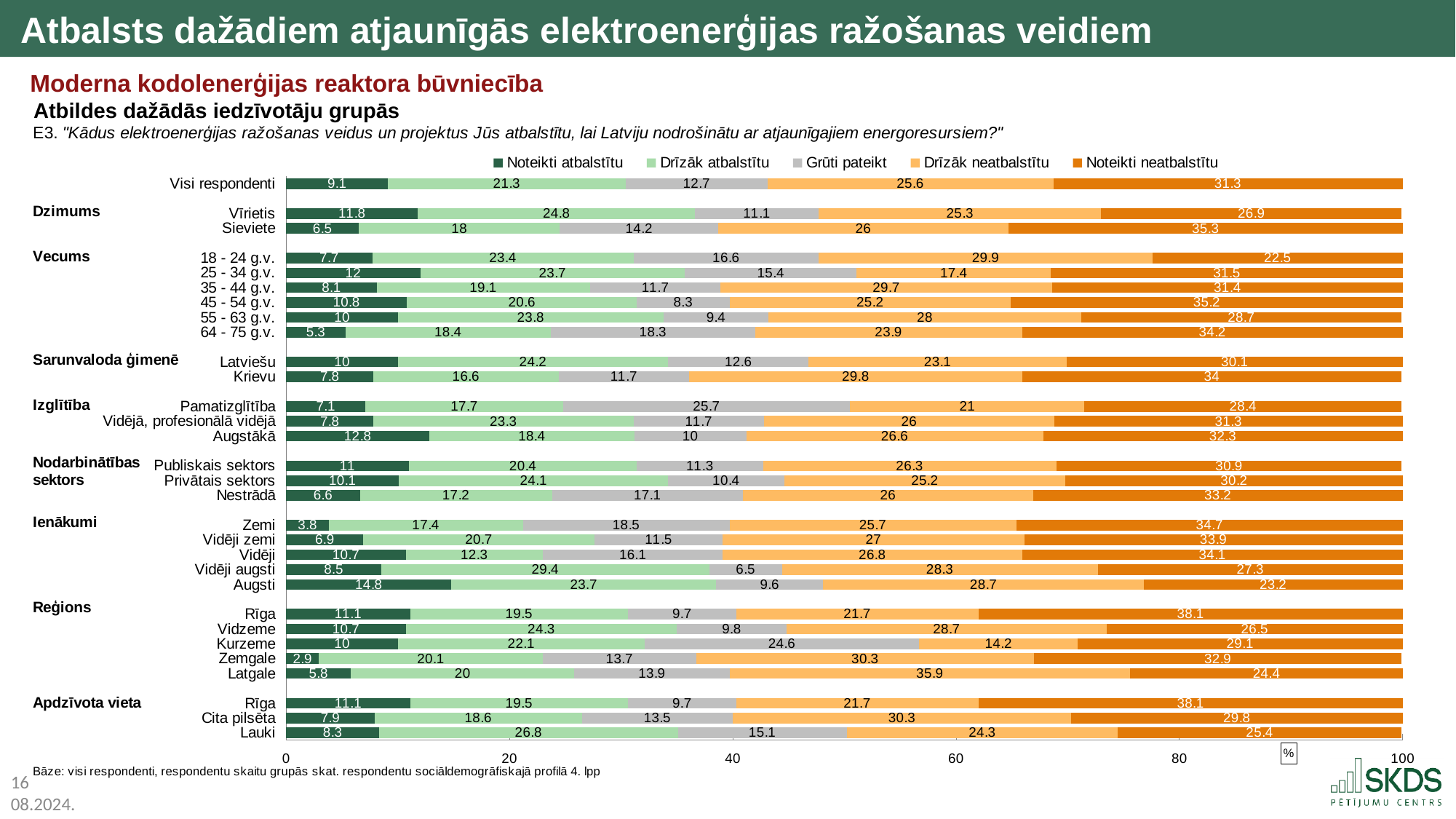
Which group has the lowest value for "Noteikti atbalstītu"? Zemgale Which group has the highest value for "Noteikti atbalstītu"? Augsti What is the value of "Drīzāk neatbalstītu" for "Latgale"? 35.9 How many series does the legend list? 5 What is the value of "Grūti pateikt" for "Pamatizglītība"? 25.7 Which has a larger "Drīzāk atbalstītu" value, "Lauki" or "Cita pilsēta"? Lauki What is the difference between the "Noteikti atbalstītu" values for "Vīrietis" and "Sieviete"? 5.3 What is the value of "Noteikti atbalstītu" for "Visi respondenti"? 9.1 What is the first entry in the chart legend? Noteikti atbalstītu What is the value of "Noteikti neatbalstītu" for "Sieviete"? 35.3 What kind of chart is shown on the slide? Stacked bar chart Which group has the highest value for "Noteikti neatbalstītu"? Rīga